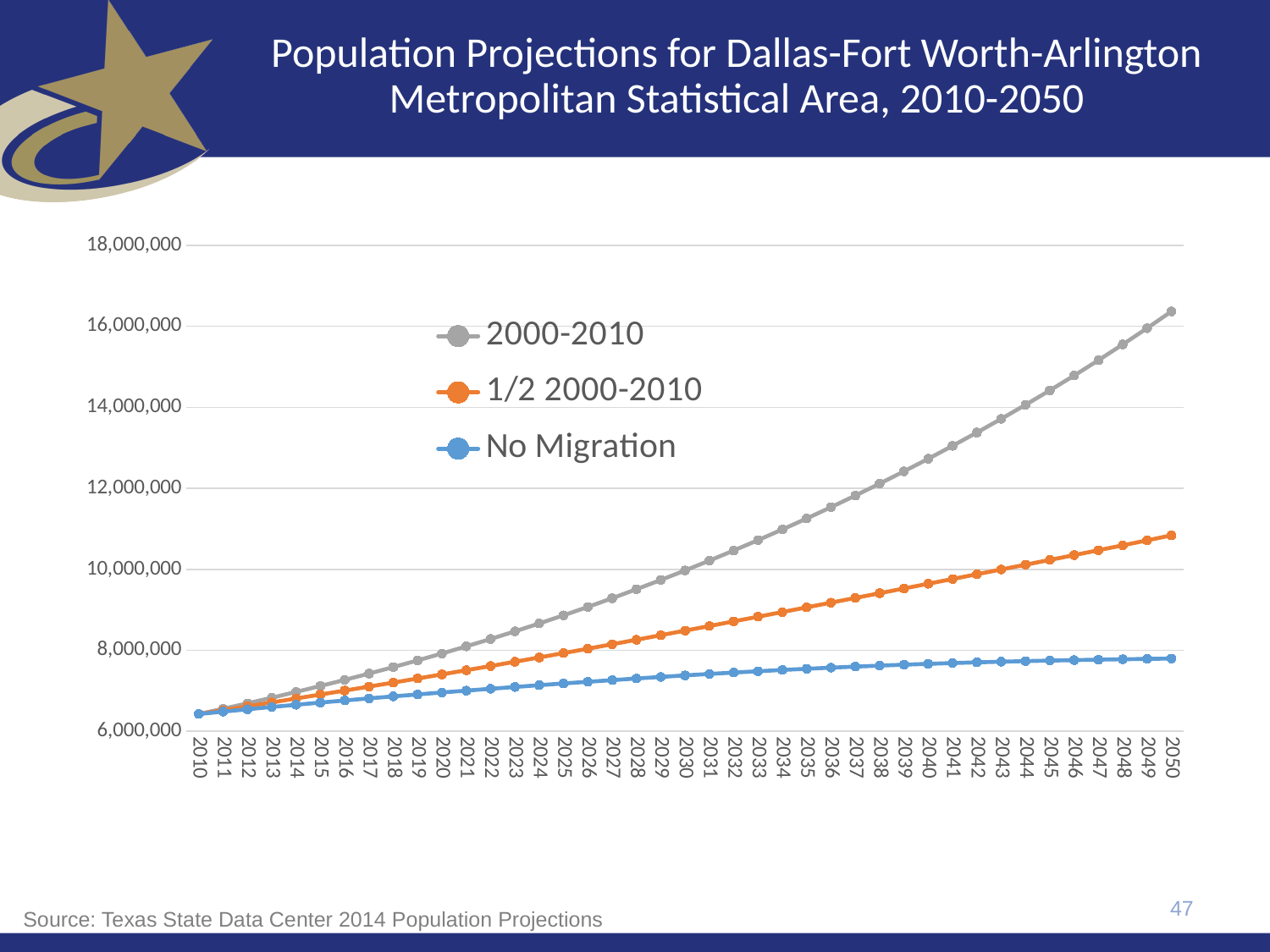
Which series has the highest value in 2050? 2000-2010 Is the value for the No Migration series in 2050 greater or less than 8,000,000? less How many series does the legend list? 3 Is the value for the 2000-2010 series in 2040 greater or less than 12,000,000? greater Is the value for the 2000-2010 series in 2050 greater or less than 16,000,000? greater Which is larger in 2040, the 1/2 2000-2010 series or the No Migration series? 1/2 2000-2010 Do the values of the 2000-2010 series rise or fall from 2010 to 2050? rise What kind of chart is shown on the slide? Line chart What is the title of the chart? Population Projections for Dallas-Fort Worth-Arlington Metropolitan Statistical Area, 2010-2050 Which series has the lowest value in 2050? No Migration How many years are plotted along the x axis? 41